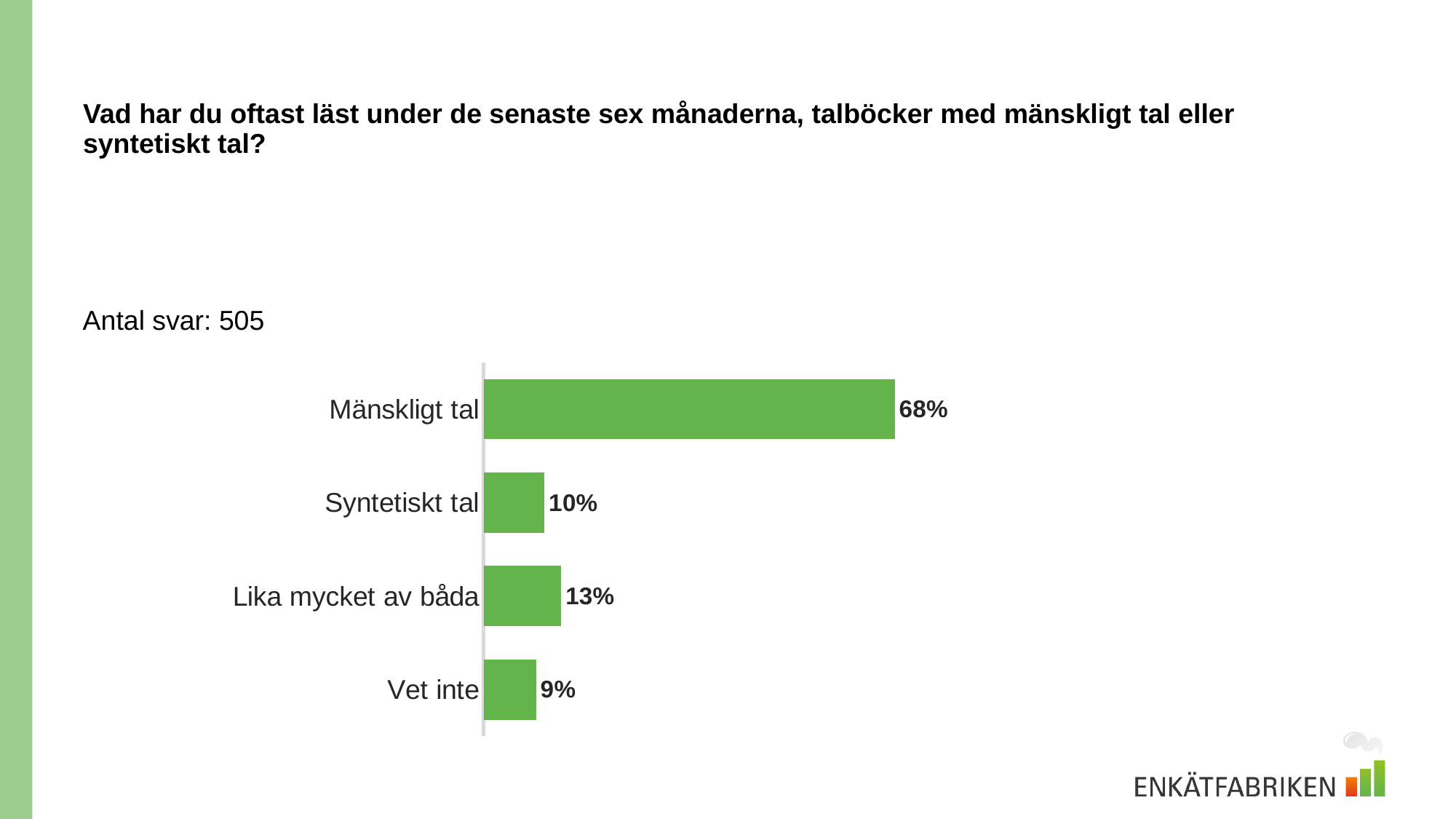
What is the difference between the values for Mänskligt tal and Syntetiskt tal? 58% What is the value for Lika mycket av båda? 13% Which category has the lowest value? Vet inte What is the value for Mänskligt tal? 68% What is the difference between the values for Lika mycket av båda and Vet inte? 4% What is the value for Vet inte? 9% How many categories are shown in the chart? 4 Which category has the highest value? Mänskligt tal Which is larger, the value for Syntetiskt tal or the value for Lika mycket av båda? Lika mycket av båda How many responses (Antal svar) does the slide report? 505 What is the value for Syntetiskt tal? 10% What kind of chart is shown on the slide? Bar chart